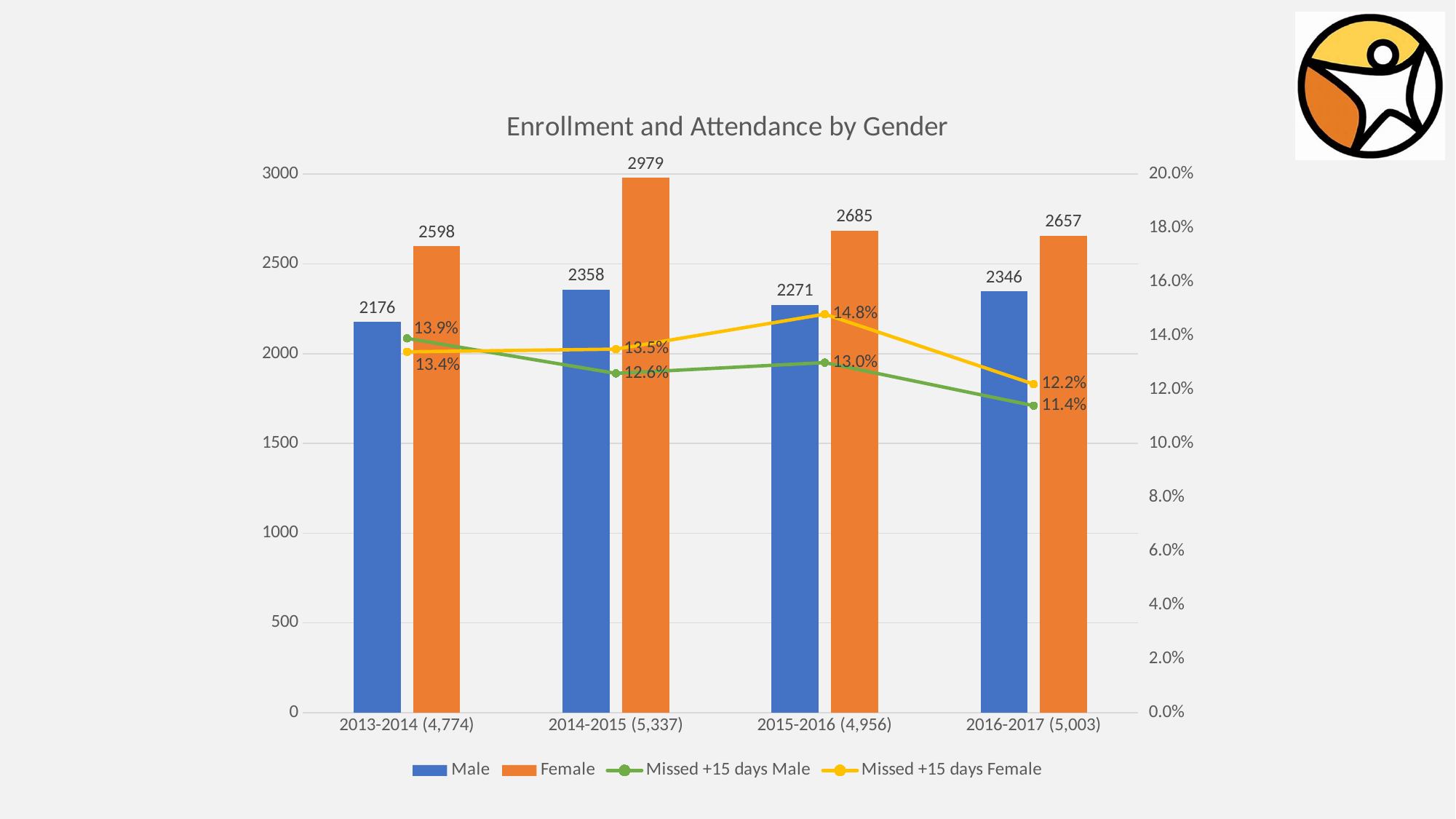
What is the Female enrollment value for 2013-2014 (4,774)? 2598 Which is larger in 2013-2014 (4,774): Missed +15 days Male or Missed +15 days Female? Missed +15 days Male How many school years are shown on the x axis? 4 What is the title of the chart? Enrollment and Attendance by Gender What is the Missed +15 days Female value for 2015-2016 (4,956)? 14.8% How many series does the legend list? 4 What is the Missed +15 days Male value for 2016-2017 (5,003)? 11.4% Does the Missed +15 days Male line rise or fall from 2015-2016 (4,956) to 2016-2017 (5,003)? fall What is the difference between Female and Male enrollment in 2014-2015 (5,337)? 621 What is the Male enrollment value for 2014-2015 (5,337)? 2358 In which year is the Female enrollment highest? 2014-2015 (5,337) In which year is the Male enrollment lowest? 2013-2014 (4,774)